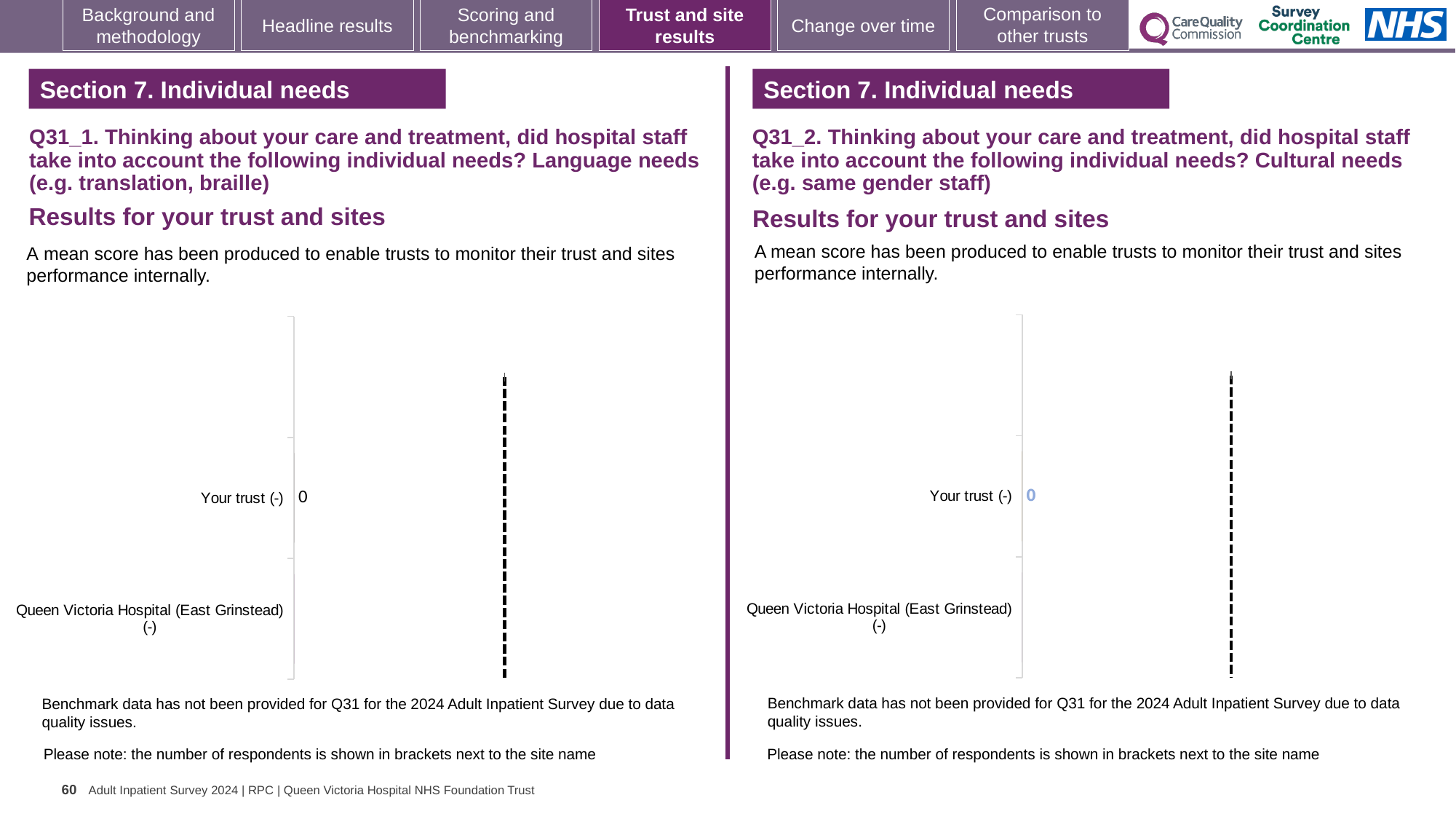
How many categories are listed on the y axis of the right chart (Q31_2, Cultural needs)? 2 How many categories are listed on the y axis of the left chart (Q31_1, Language needs)? 2 On the right chart (Q31_2, Cultural needs), what is shown in brackets next to Your trust as the number of respondents? - On the left chart (Q31_1, Language needs), which site is listed below Your trust? Queen Victoria Hospital (East Grinstead) On the left chart (Q31_1, Language needs), what value is shown for Your trust? 0 What kind of chart is used on the left (Q31_1, Language needs)? Bar chart On the right chart (Q31_2, Cultural needs), what value is shown for Your trust? 0